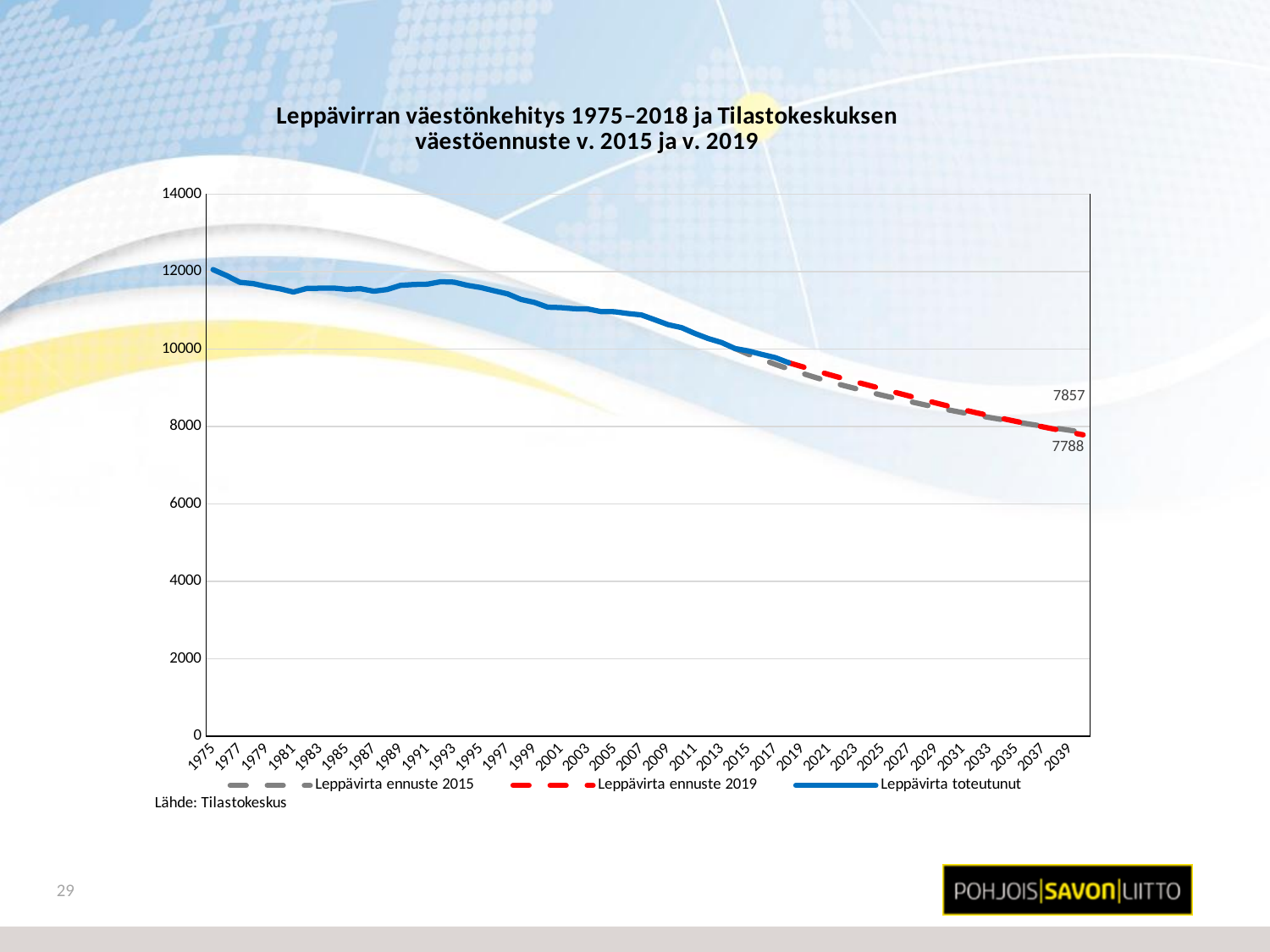
What source is cited below the chart? Tilastokeskus What is the final labelled value of the Leppävirta ennuste 2019 series? 7788 Is the Leppävirta ennuste 2019 value in 2031 greater or less than 8000? greater Which forecast series ends at a higher value, Leppävirta ennuste 2015 or Leppävirta ennuste 2019? Leppävirta ennuste 2015 What colour is the Leppävirta toteutunut line? blue What kind of chart is shown on the slide? line chart How many series does the legend list? 3 Is the Leppävirta toteutunut value in 1975 greater or less than 10000? greater Does the Leppävirta toteutunut series generally rise or fall from 1975 to 2018? fall What is the final labelled value of the Leppävirta ennuste 2015 series? 7857 Is the Leppävirta toteutunut value in 2007 greater or less than 10000? greater What is the difference between the final labelled values of the ennuste 2015 (7857) and ennuste 2019 (7788) series? 69